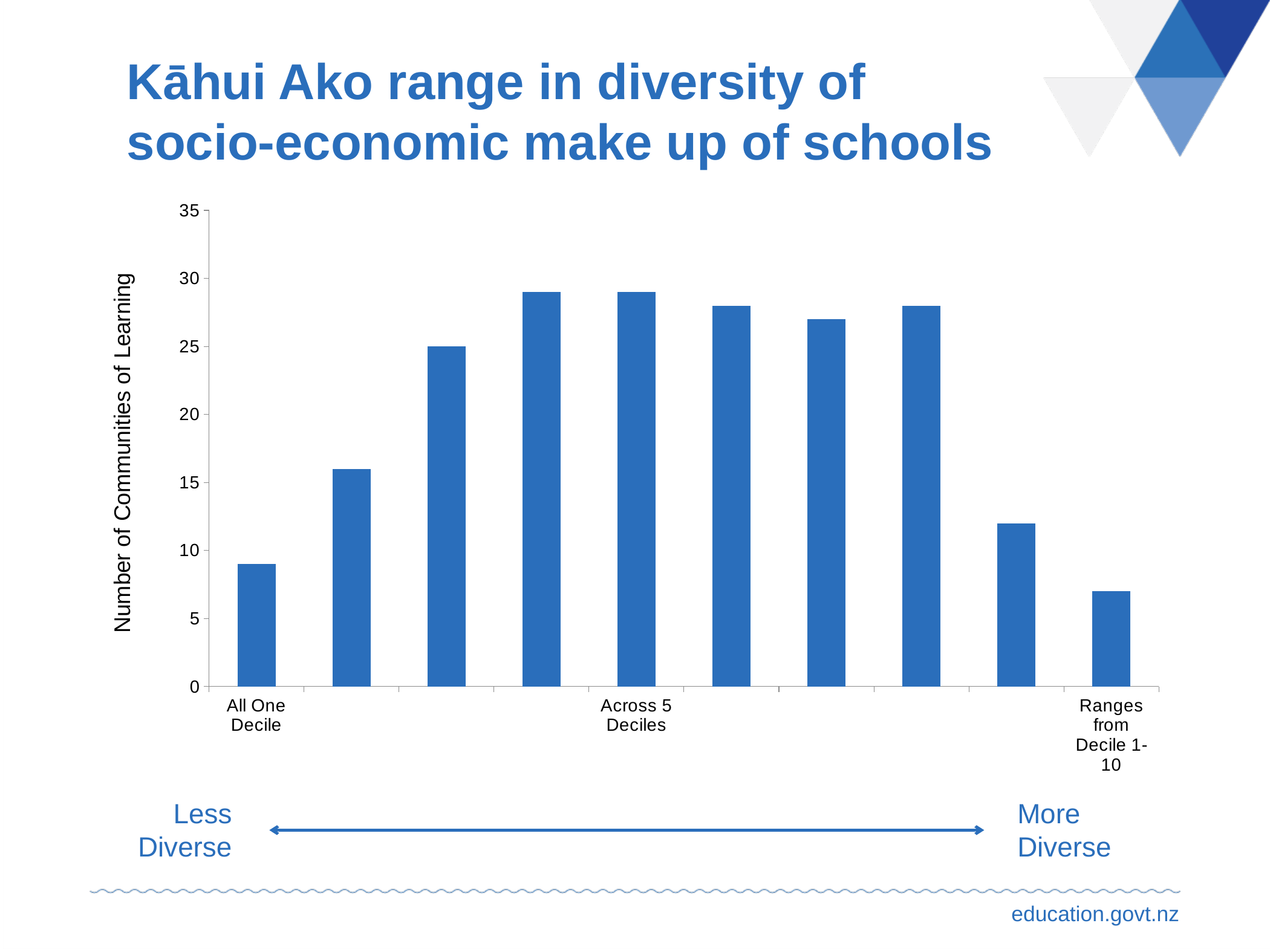
What kind of chart is shown on the slide? bar chart What is the title of the vertical axis? Number of Communities of Learning Is the value for Ranges from Decile 1-10 greater or less than 10? less Is the value for All One Decile greater or less than 5? greater What is the title of the slide? Kāhui Ako range in diversity of socio-economic make up of schools How many bars are plotted in the chart? 10 Which of the labelled categories has the lowest number of Communities of Learning? Ranges from Decile 1-10 Is the value for Across 5 Deciles greater or less than 25? greater Which is larger, the value for All One Decile or the value for Across 5 Deciles? Across 5 Deciles Which is larger, the value for All One Decile or the value for Ranges from Decile 1-10? All One Decile